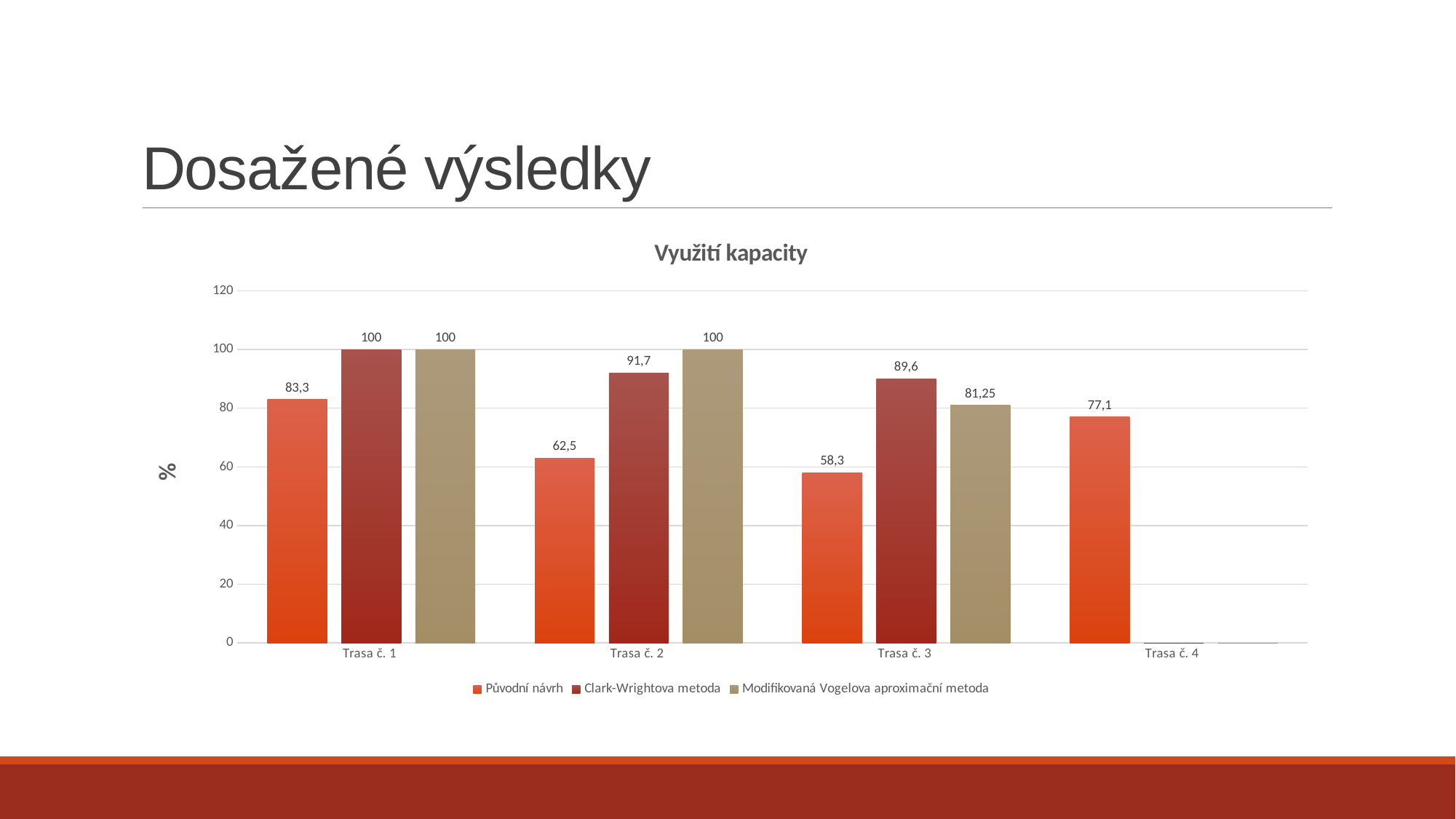
How many categories (routes) are shown on the x axis? 4 What is the value for Původní návrh for Trasa č. 1? 83,3 What is the difference between Clark-Wrightova metoda and Původní návrh for Trasa č. 3? 31,3 What is the value for Modifikovaná Vogelova aproximační metoda for Trasa č. 3? 81,25 What is the title of the chart? Využití kapacity What is the value for Původní návrh for Trasa č. 4? 77,1 Does the value for Původní návrh fall or rise from Trasa č. 1 to Trasa č. 3? fall How many series does the legend list? 3 Which route has the lowest value for Původní návrh? Trasa č. 3 What kind of chart is shown on the slide? bar chart Which is larger for Trasa č. 2: Clark-Wrightova metoda or Modifikovaná Vogelova aproximační metoda? Modifikovaná Vogelova aproximační metoda What is the value for Clark-Wrightova metoda for Trasa č. 2? 91,7